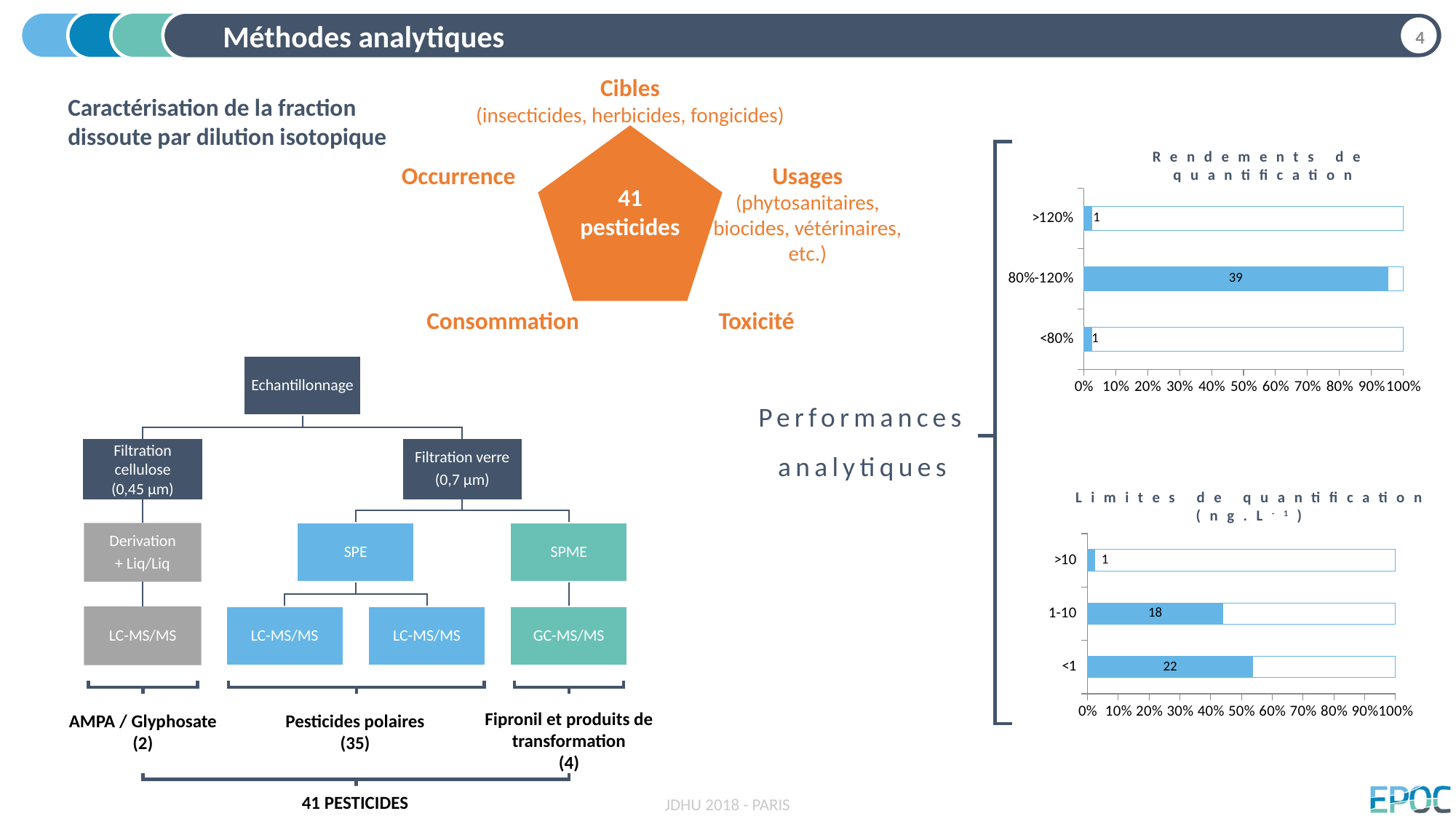
In the 'Limites de quantification (ng.L-1)' chart, what is the data label for the <1 category? 22 In the 'Limites de quantification (ng.L-1)' chart, which has the larger value, <1 or 1-10? <1 In the 'Limites de quantification (ng.L-1)' chart, what is the data label for the 1-10 category? 18 In the 'Limites de quantification (ng.L-1)' chart, what is the difference between the data labels for <1 and 1-10? 4 In the 'Limites de quantification (ng.L-1)' chart, is the bar for 1-10 greater or less than 50%? less In the 'Rendements de quantification' chart, which category has the longest bar? 80%-120% In the 'Rendements de quantification' chart, what is the data label for the 80%-120% category? 39 In the 'Limites de quantification (ng.L-1)' chart, which category has the smallest value? >10 In the 'Rendements de quantification' chart, what is the data label for the >120% category? 1 In the 'Rendements de quantification' chart, how many categories are shown on the vertical axis? 3 In the 'Rendements de quantification' chart, is the bar for 80%-120% greater or less than 90%? greater What type of chart is the 'Limites de quantification (ng.L-1)' chart? bar chart